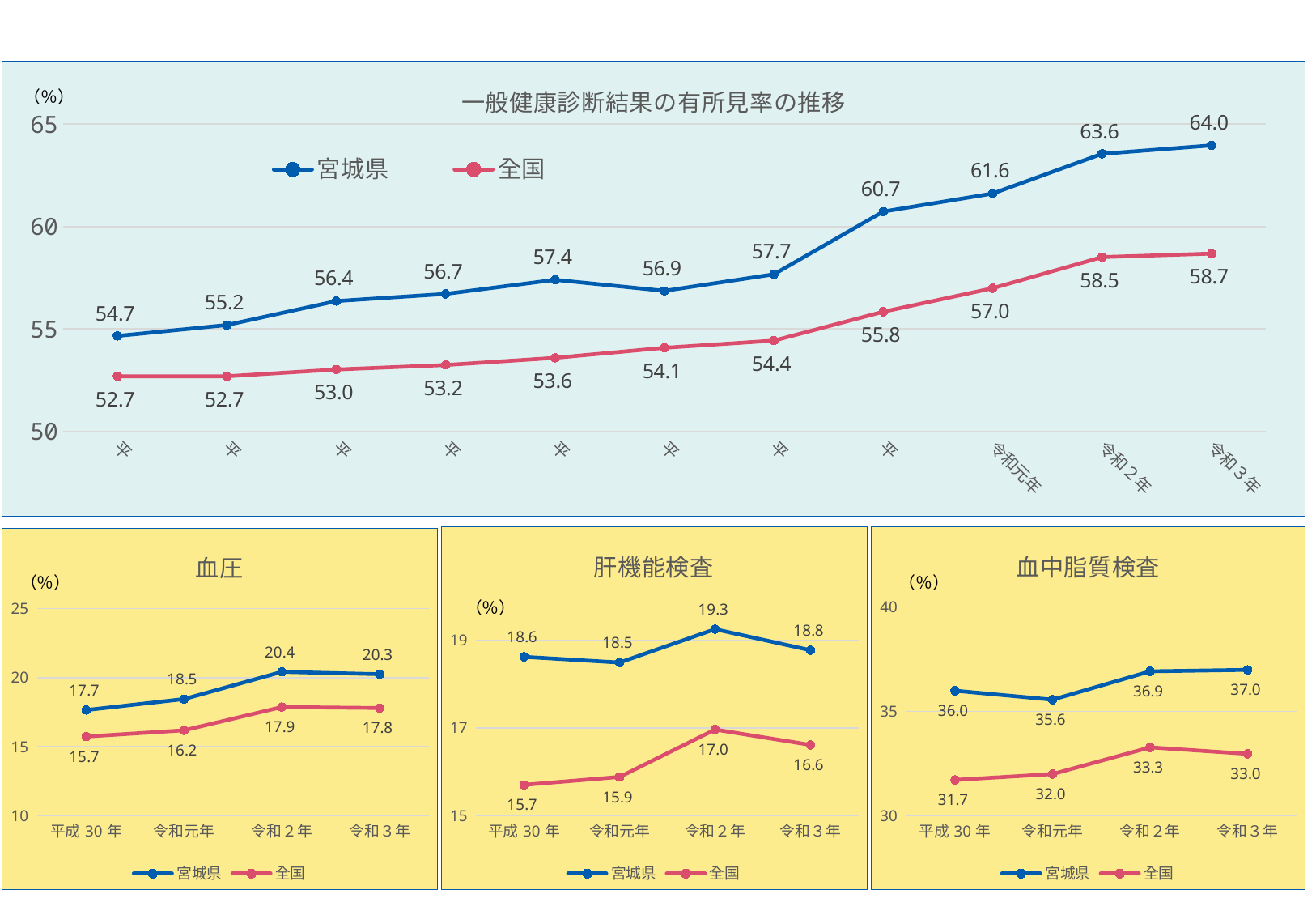
In the chart titled 肝機能検査, which year has the highest value for 宮城県? 令和2年 In the chart titled 一般健康診断結果の有所見率の推移, does the 全国 line generally rise or fall from left to right? rise In the chart titled 血圧, what is the value for 宮城県 in 令和2年? 20.4 In the chart titled 一般健康診断結果の有所見率の推移, how many data points does each line have? 11 In the chart titled 一般健康診断結果の有所見率の推移, what is the value for 全国 in 令和元年? 57.0 In the chart titled 血中脂質検査, what is the difference between 宮城県 and 全国 in 平成30年? 4.3 In the chart titled 一般健康診断結果の有所見率の推移, what kind of chart is shown? line chart In the chart titled 血圧, which year has the lowest value for 全国? 平成30年 In the chart titled 一般健康診断結果の有所見率の推移, what is the difference between 宮城県 and 全国 in 令和2年? 5.1 In the chart titled 一般健康診断結果の有所見率の推移, what is the value for 宮城県 in 令和3年? 64.0 In the chart titled 血中脂質検査, how many series does the legend list? 2 In the chart titled 肝機能検査, what is the value for 全国 in 令和3年? 16.6